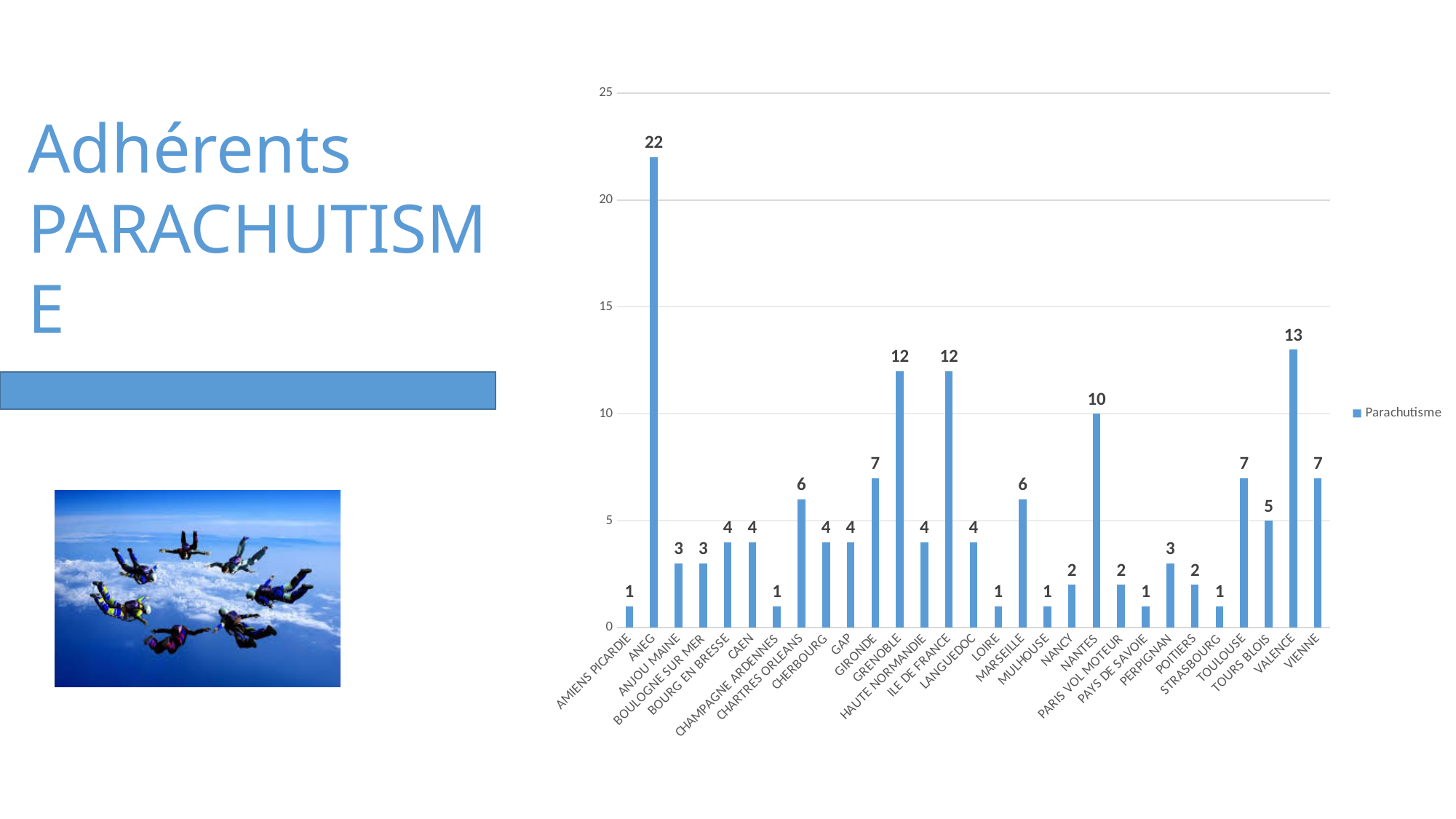
Which is larger, the value for MARSEILLE or the value for TOULOUSE? TOULOUSE How many series does the legend list? 1 What is the value for VALENCE? 13 How many categories are shown on the x axis? 29 What is the value for ANEG? 22 What is the difference between the values for ANEG and VALENCE? 9 Is the value for ANEG greater or less than 20? greater What is the value for NANTES? 10 What is the value for TOURS BLOIS? 5 What is the difference between the values for GRENOBLE and NANTES? 2 Which category has the highest value? ANEG What kind of chart is shown on the slide? bar chart